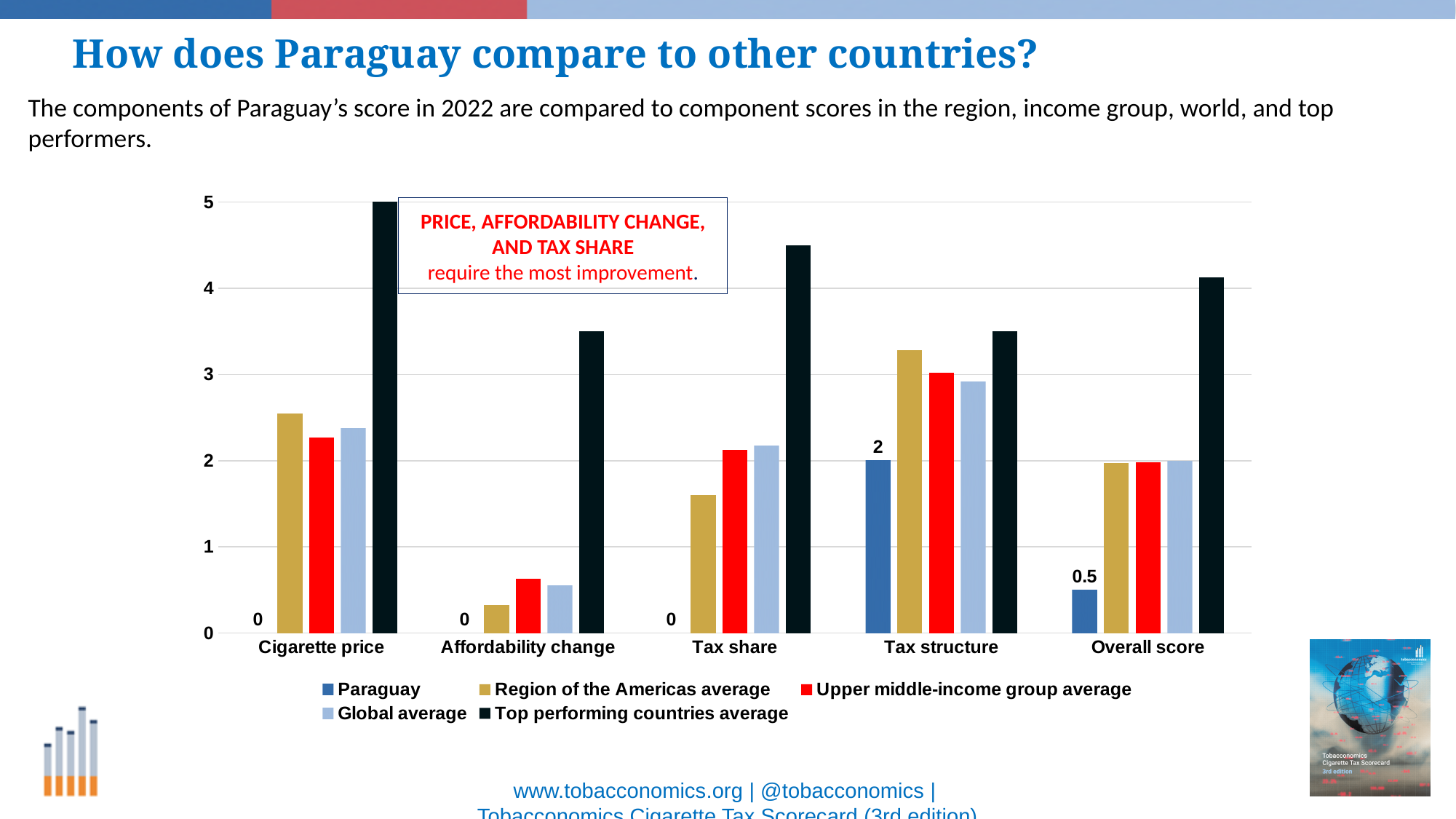
What is Paraguay's value for Overall score? 0.5 How many categories are shown on the x axis of the chart? 5 Which series has the highest value for Tax share? Top performing countries average Is the Top performing countries average value for Affordability change greater or less than 3? greater In which category does Paraguay have its highest value? Tax structure What is the Top performing countries average value for Cigarette price? 5 What is the difference between Paraguay's Tax structure value and its Overall score value? 1.5 What kind of chart is shown on the slide? Bar chart What is Paraguay's value for Tax structure? 2 How many series does the legend list? 5 Is the Region of the Americas average value for Cigarette price greater or less than 2? greater What is Paraguay's value for Cigarette price? 0